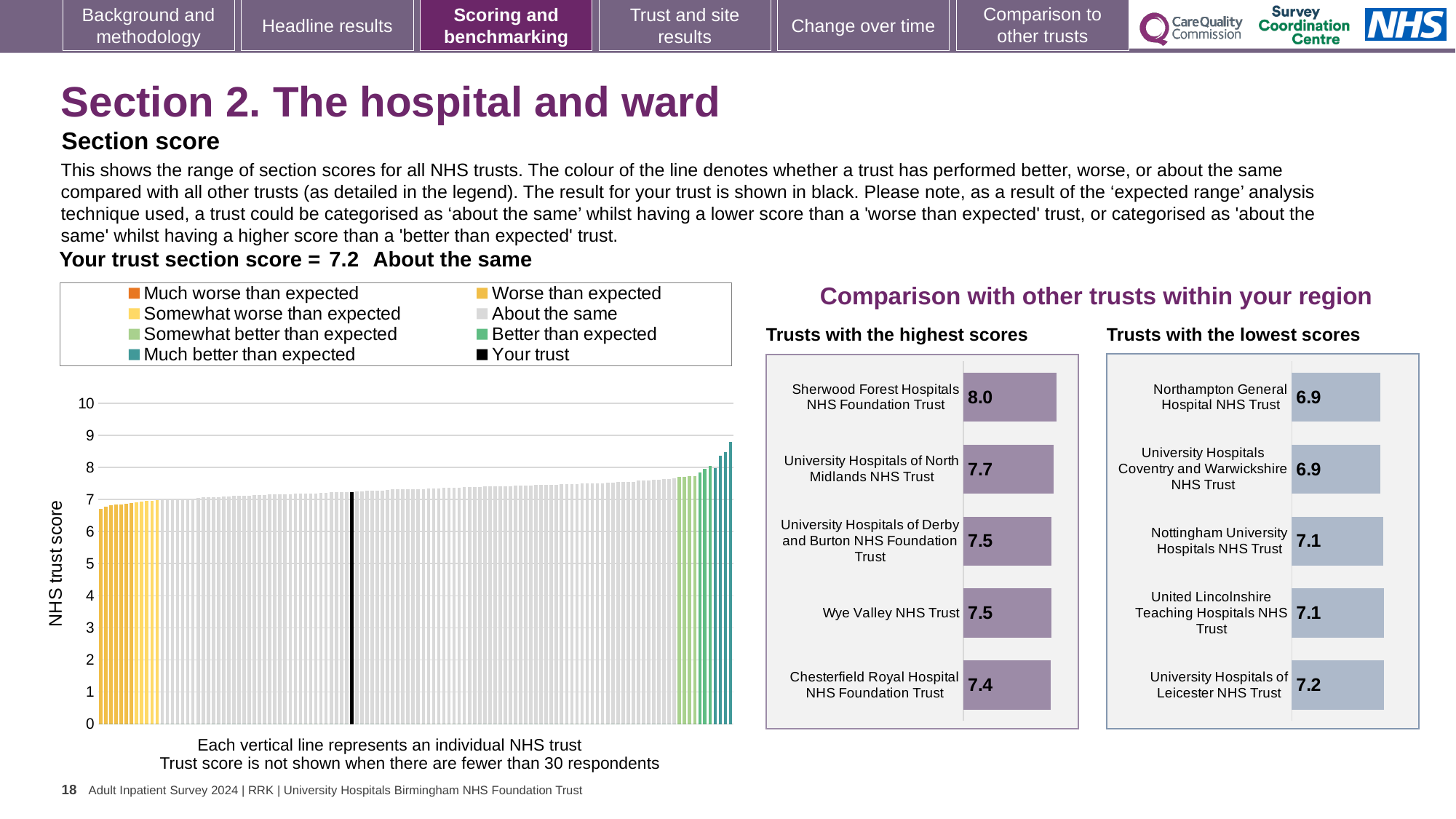
In the 'Trusts with the highest scores' chart, what is the score for Chesterfield Royal Hospital NHS Foundation Trust? 7.4 How many trusts are shown in the 'Trusts with the lowest scores' chart? 5 What kind of chart is the NHS trust score chart on the left of the slide? bar chart In the 'Trusts with the highest scores' chart, which has the larger score: University Hospitals of North Midlands NHS Trust or Wye Valley NHS Trust? University Hospitals of North Midlands NHS Trust How many entries does the legend of the NHS trust score chart on the left list? 8 In the 'Trusts with the highest scores' chart, what is the score for Sherwood Forest Hospitals NHS Foundation Trust? 8.0 In the 'Trusts with the lowest scores' chart, what is the score for Nottingham University Hospitals NHS Trust? 7.1 In the 'Trusts with the highest scores' chart, which trust has the highest score? Sherwood Forest Hospitals NHS Foundation Trust In the 'Trusts with the lowest scores' chart, which trust has the highest score? University Hospitals of Leicester NHS Trust In the NHS trust score chart on the left, what is the section score for your trust (the black bar)? 7.2 In the 'Trusts with the highest scores' chart, what is the difference between the scores of Sherwood Forest Hospitals NHS Foundation Trust and Chesterfield Royal Hospital NHS Foundation Trust? 0.6 In the NHS trust score chart on the left, is the value of the tallest bar greater or less than 8? greater